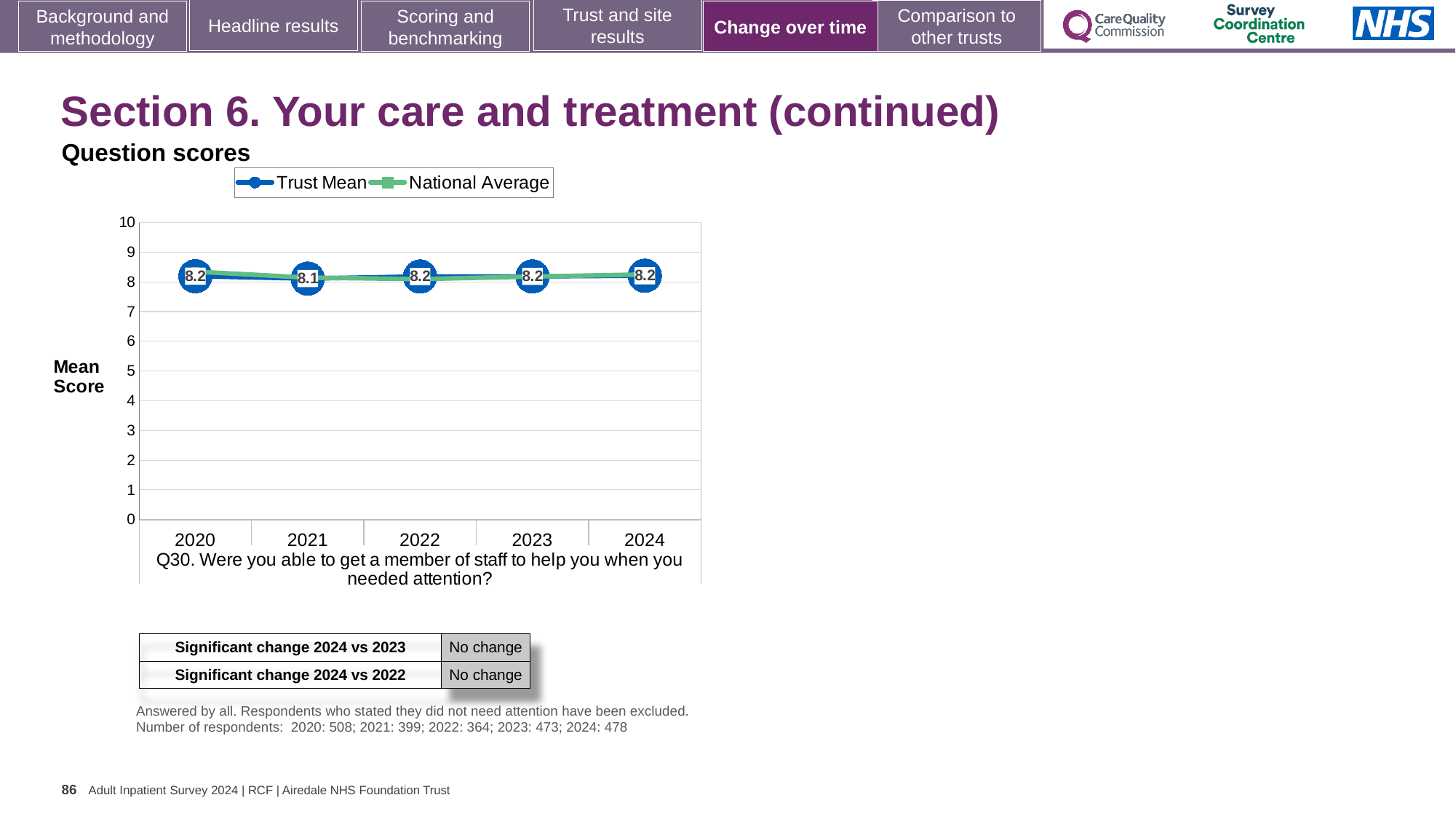
What are the two series named in the legend? Trust Mean and National Average What is the Trust Mean score for 2020? 8.2 What is the difference between the Trust Mean scores for 2022 and 2021? 0.1 What kind of chart is shown on the slide? line chart How many years are plotted on the x axis? 5 What is the Trust Mean score for 2021? 8.1 What is the Trust Mean score for 2024? 8.2 Is the National Average value for 2020 greater or less than 5? greater Does the Trust Mean score rise or fall from 2021 to 2022? rise In which year is the Trust Mean score lowest? 2021 How many series does the legend list? 2 Which is larger, the Trust Mean score for 2021 or for 2023? 2023